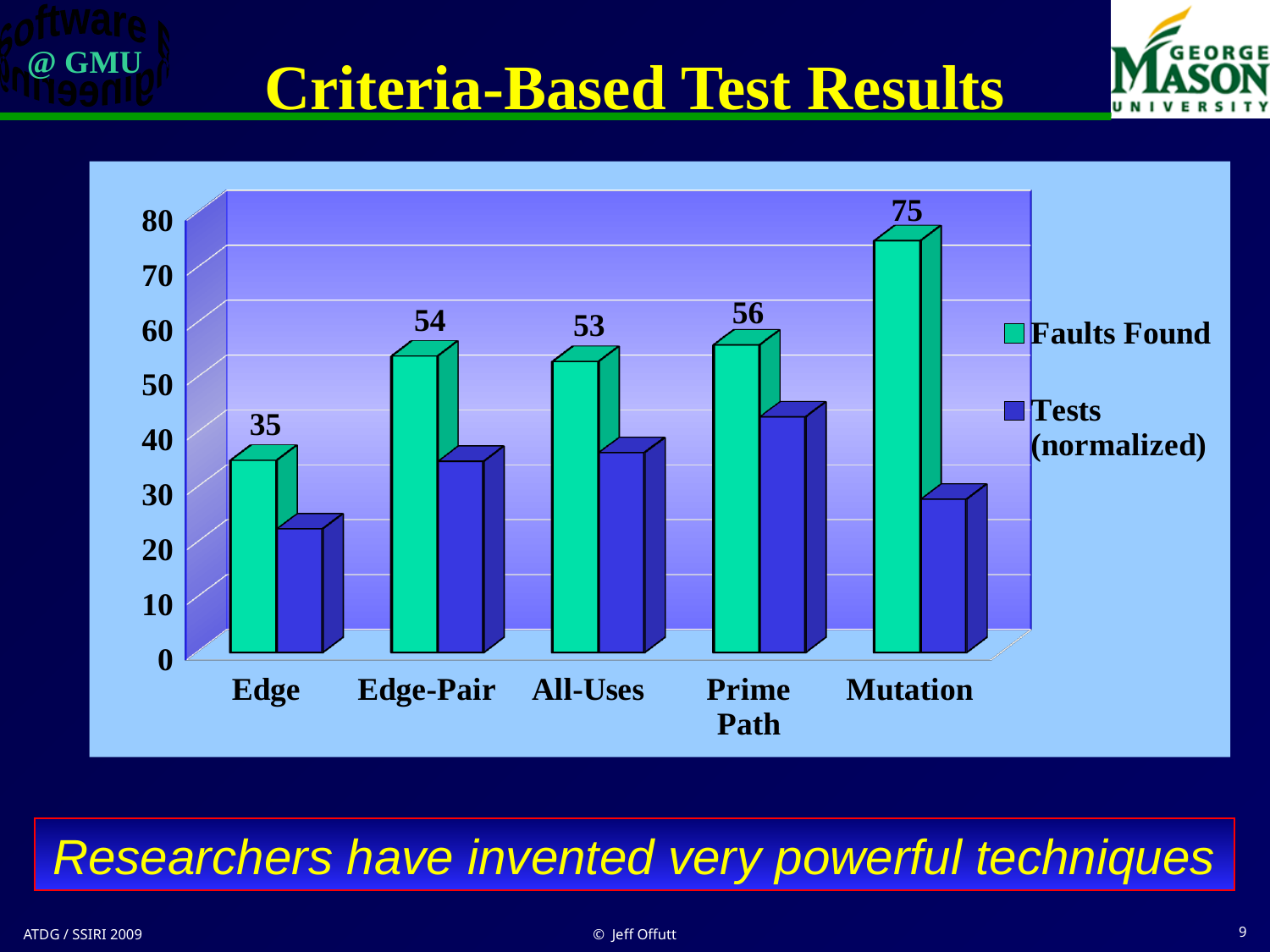
Which criterion has the lowest Faults Found value? Edge Is the Tests (normalized) value for Prime Path greater or less than 30? greater Which criterion has the highest Faults Found value? Mutation What is the difference in Faults Found between Mutation and Edge? 40 What is the Faults Found value for Edge-Pair? 54 Which has a higher Faults Found value, Edge-Pair or All-Uses? Edge-Pair How many criteria are shown on the x axis? 5 How many series does the legend list? 2 Which criterion has the highest Tests (normalized) value? Prime Path What kind of chart is shown on the slide? Bar chart What is the Faults Found value for Mutation? 75 Is the Tests (normalized) value for Edge greater or less than 30? less